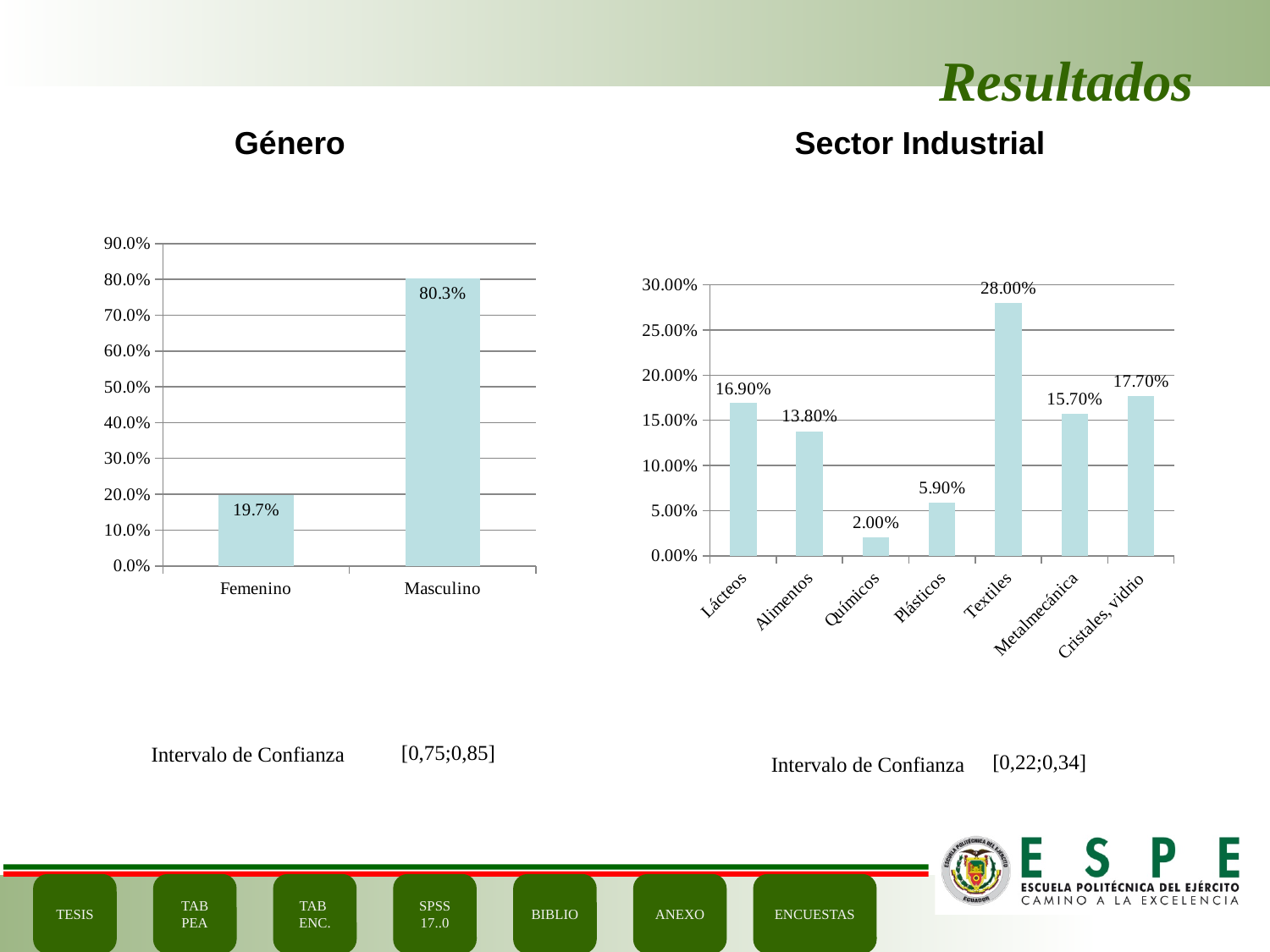
In the Género chart, what is the value for Femenino? 19.7% What type of chart is the Sector Industrial chart? Bar chart In the Sector Industrial chart, what is the value for Textiles? 28.00% In the Sector Industrial chart, what is the difference between Cristales, vidrio and Metalmecánica? 2.00% In the Sector Industrial chart, what is the value for Químicos? 2.00% In the Sector Industrial chart, which sector has the highest value? Textiles In the Género chart, how many categories are shown? 2 In the Sector Industrial chart, how many sectors are shown? 7 In the Sector Industrial chart, which is larger, Lácteos or Alimentos? Lácteos In the Género chart, what is the value for Masculino? 80.3% In the Sector Industrial chart, which sector has the lowest value? Químicos In the Género chart, what is the difference between Masculino and Femenino? 60.6%